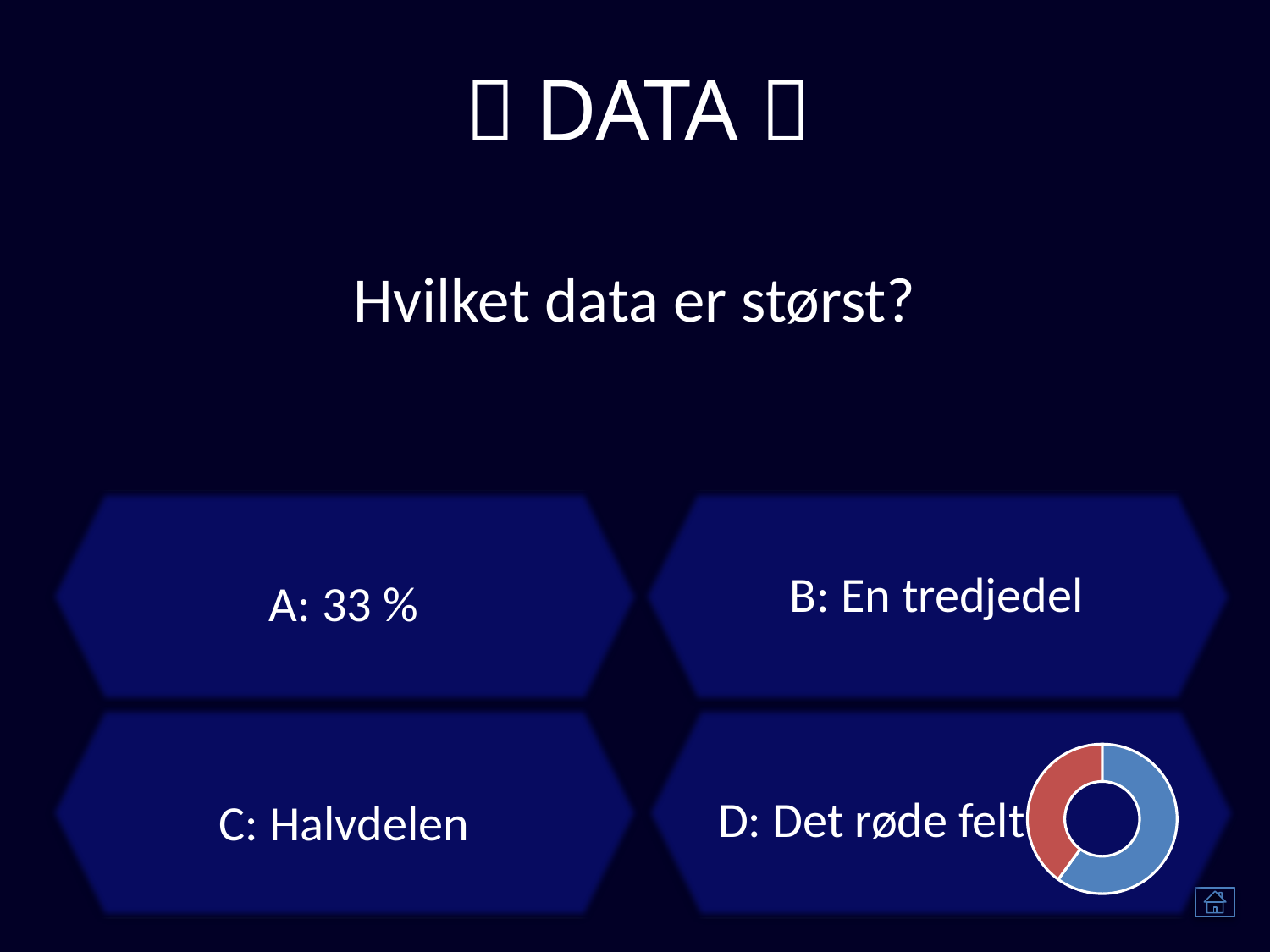
Which slice of the doughnut chart is the largest? the blue slice How many slices does the doughnut chart have? 2 Which slice of the doughnut chart is larger, the red one or the blue one? blue What kind of chart is shown on the slide? doughnut chart Which slice of the doughnut chart is the smallest? the red slice Does the doughnut chart have a legend? No What colours are the two slices of the doughnut chart? red and blue